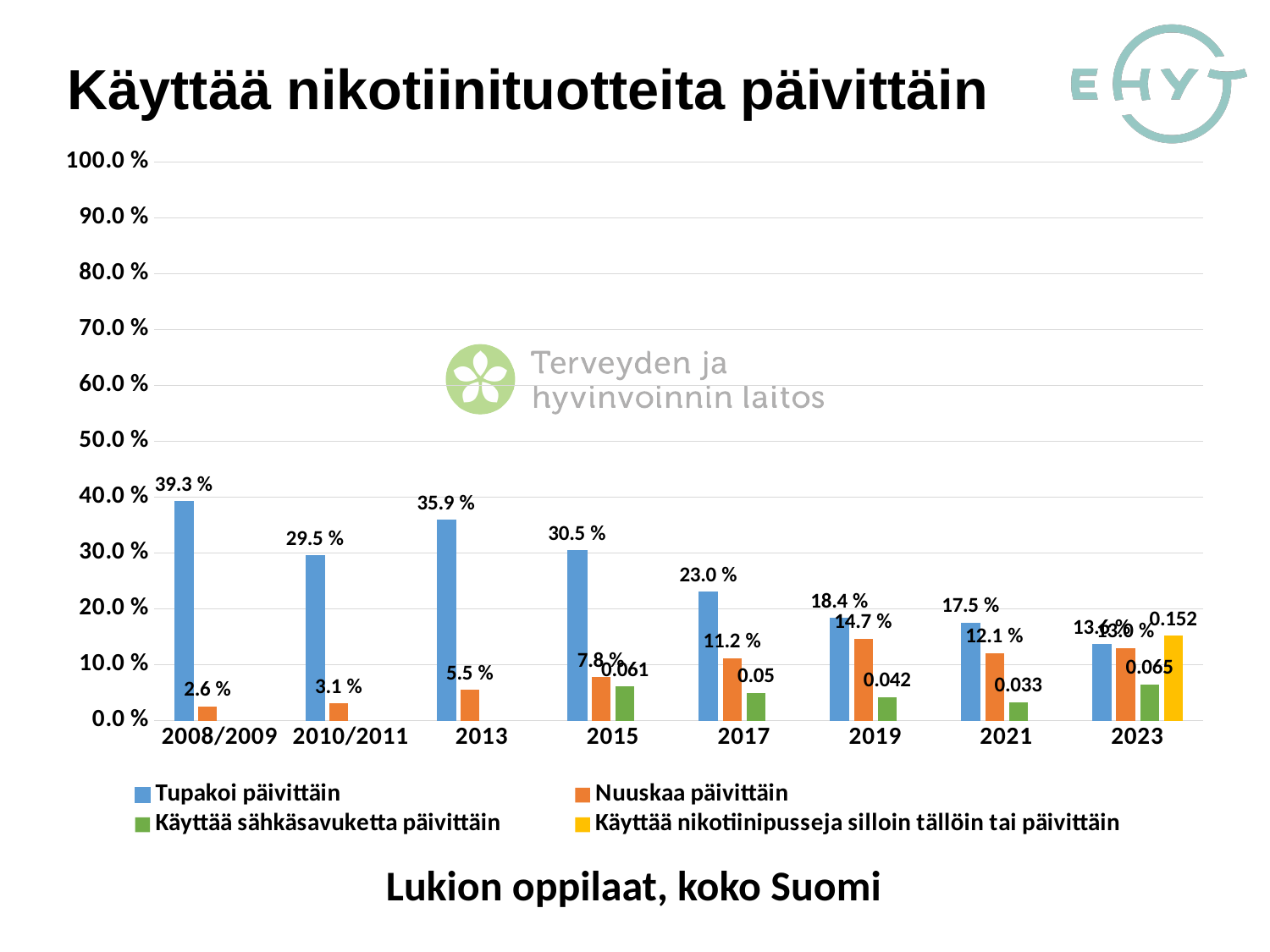
How many year categories are shown on the x axis? 8 What is the value for Tupakoi päivittäin in 2008/2009? 39.3 % What is the value for Käyttää nikotiinipusseja silloin tällöin tai päivittäin in 2023? 0.152 What is the value for Nuuskaa päivittäin in 2017? 11.2 % What type of chart is shown on the slide? bar chart What is the value for Käyttää sähkösavuketta päivittäin in 2019? 0.042 Which is larger in 2019: Tupakoi päivittäin or Nuuskaa päivittäin? Tupakoi päivittäin Does the value for Tupakoi päivittäin generally rise or fall from 2013 to 2021? fall How many series does the legend list? 4 What is the difference between the Tupakoi päivittäin values in 2013 and 2015? 5.4 % In which year is the value for Nuuskaa päivittäin lowest? 2008/2009 In which year is the value for Tupakoi päivittäin highest? 2008/2009